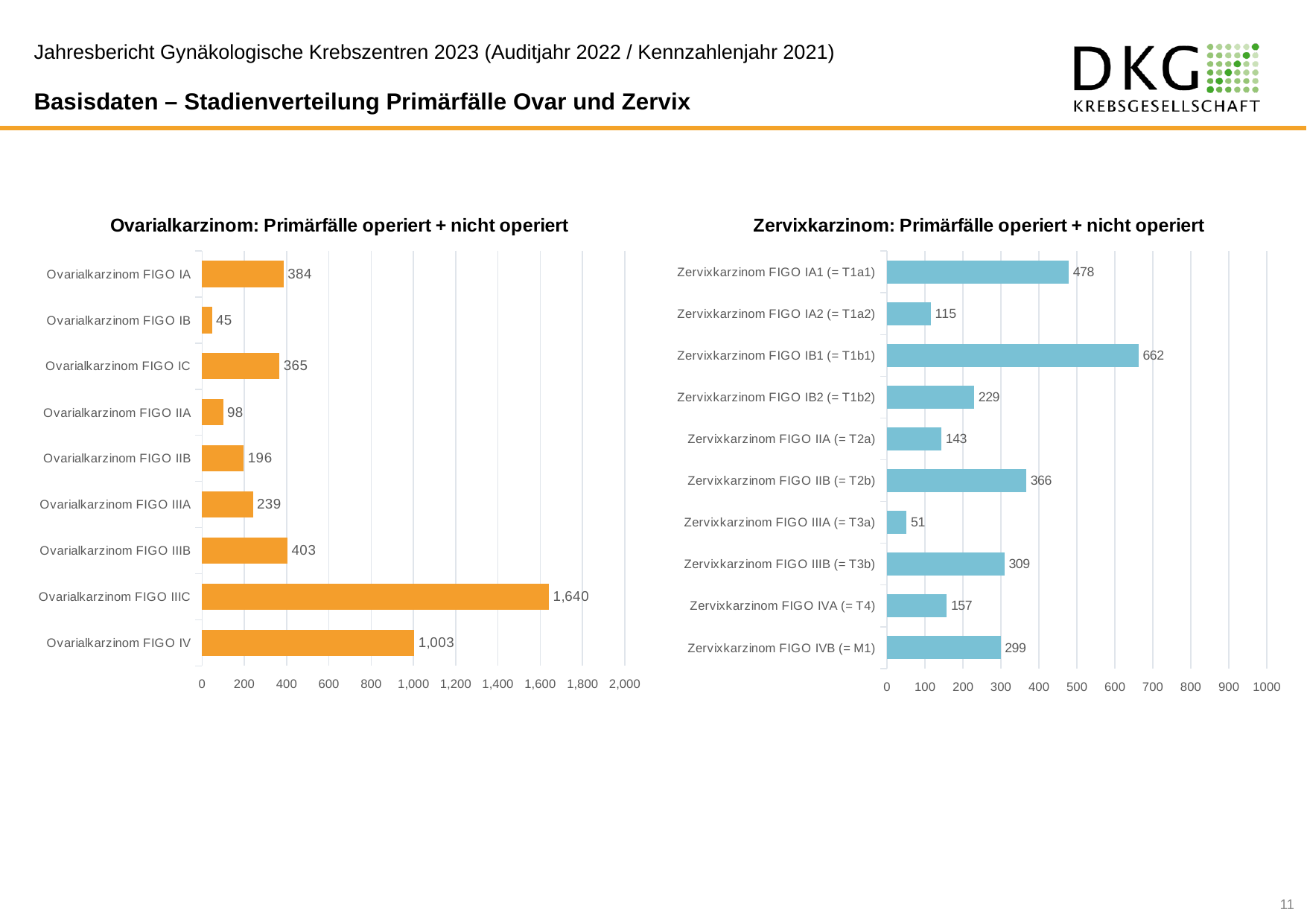
What type of chart is the 'Zervixkarzinom: Primärfälle operiert + nicht operiert' chart? Bar chart In the 'Ovarialkarzinom: Primärfälle operiert + nicht operiert' chart, which is larger: Ovarialkarzinom FIGO IA or Ovarialkarzinom FIGO IIIB? Ovarialkarzinom FIGO IIIB In the 'Ovarialkarzinom: Primärfälle operiert + nicht operiert' chart, what is the value for Ovarialkarzinom FIGO IIIC? 1,640 How many categories are shown in the 'Ovarialkarzinom: Primärfälle operiert + nicht operiert' chart? 9 In the 'Ovarialkarzinom: Primärfälle operiert + nicht operiert' chart, which category has the lowest value? Ovarialkarzinom FIGO IB How many categories are shown in the 'Zervixkarzinom: Primärfälle operiert + nicht operiert' chart? 10 In the 'Zervixkarzinom: Primärfälle operiert + nicht operiert' chart, which category has the highest value? Zervixkarzinom FIGO IB1 (= T1b1) In the 'Zervixkarzinom: Primärfälle operiert + nicht operiert' chart, what is the value for Zervixkarzinom FIGO IIB (= T2b)? 366 In the 'Zervixkarzinom: Primärfälle operiert + nicht operiert' chart, is the value for Zervixkarzinom FIGO IIIB (= T3b) greater or less than 400? less In the 'Zervixkarzinom: Primärfälle operiert + nicht operiert' chart, what is the difference between Zervixkarzinom FIGO IA1 (= T1a1) and Zervixkarzinom FIGO IA2 (= T1a2)? 363 In the 'Ovarialkarzinom: Primärfälle operiert + nicht operiert' chart, what is the difference between Ovarialkarzinom FIGO IIIC and Ovarialkarzinom FIGO IV? 637 In the 'Zervixkarzinom: Primärfälle operiert + nicht operiert' chart, which category has the lowest value? Zervixkarzinom FIGO IIIA (= T3a)